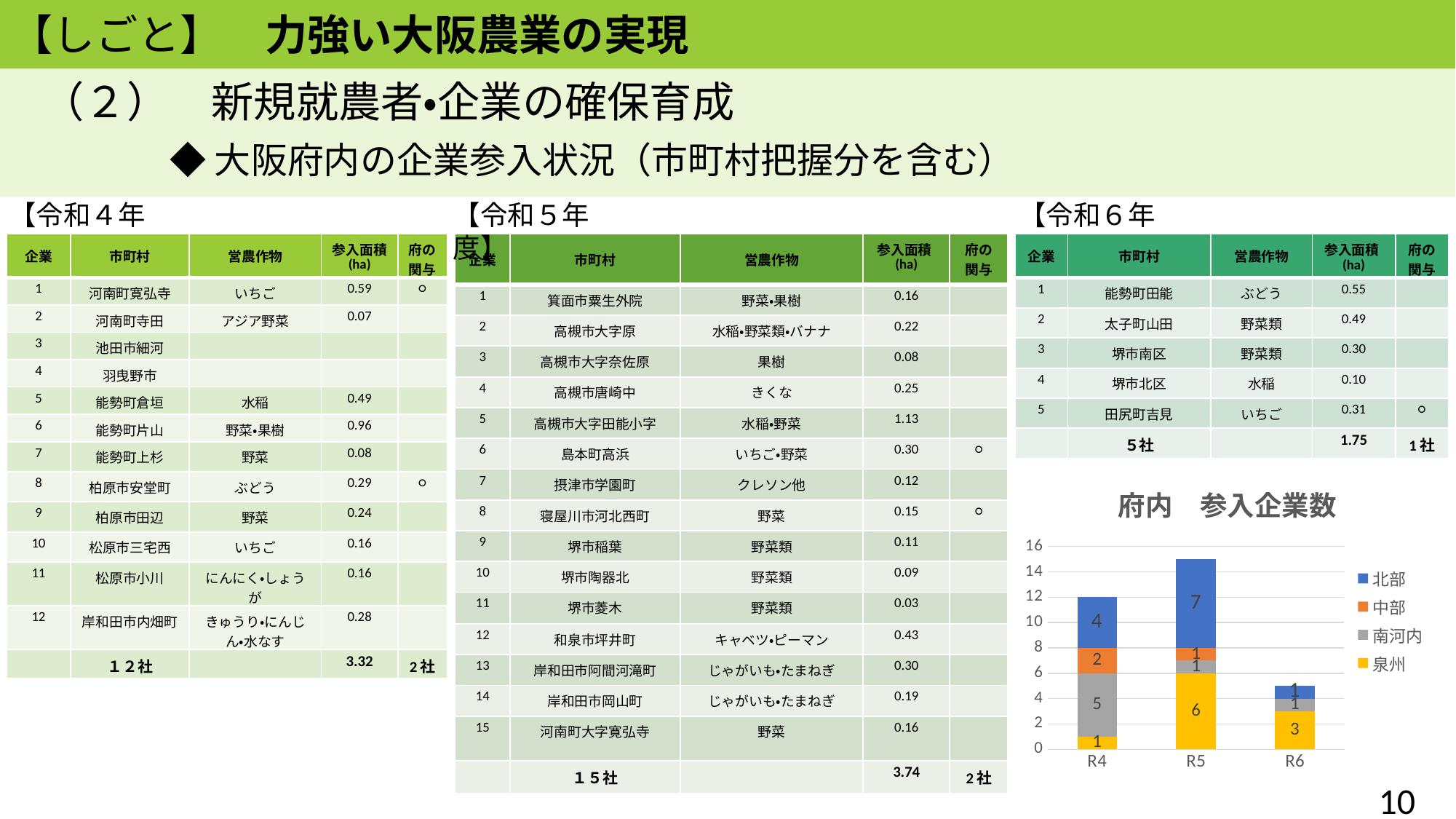
In the 府内 参入企業数 chart, what is the value for 北部 in R5? 7 In the 府内 参入企業数 chart, what is the value for 泉州 in R6? 3 In the 府内 参入企業数 chart, what is the difference between the 泉州 values for R5 and R4? 5 How many series does the legend of the 府内 参入企業数 chart list? 4 What kind of chart is the 府内 参入企業数 chart? stacked bar chart In the 府内 参入企業数 chart, what is the total of the stacked bar for R4? 12 In the 府内 参入企業数 chart, which is larger: 北部 in R4 or 北部 in R5? 北部 in R5 In the 府内 参入企業数 chart, what is the total of the stacked bar for R5? 15 How many categories are shown on the x axis of the 府内 参入企業数 chart? 3 In the 府内 参入企業数 chart, what is the value for 南河内 in R4? 5 In the 府内 参入企業数 chart, what is the value for 中部 in R4? 2 In the 府内 参入企業数 chart, which year has the lowest total number of companies? R6